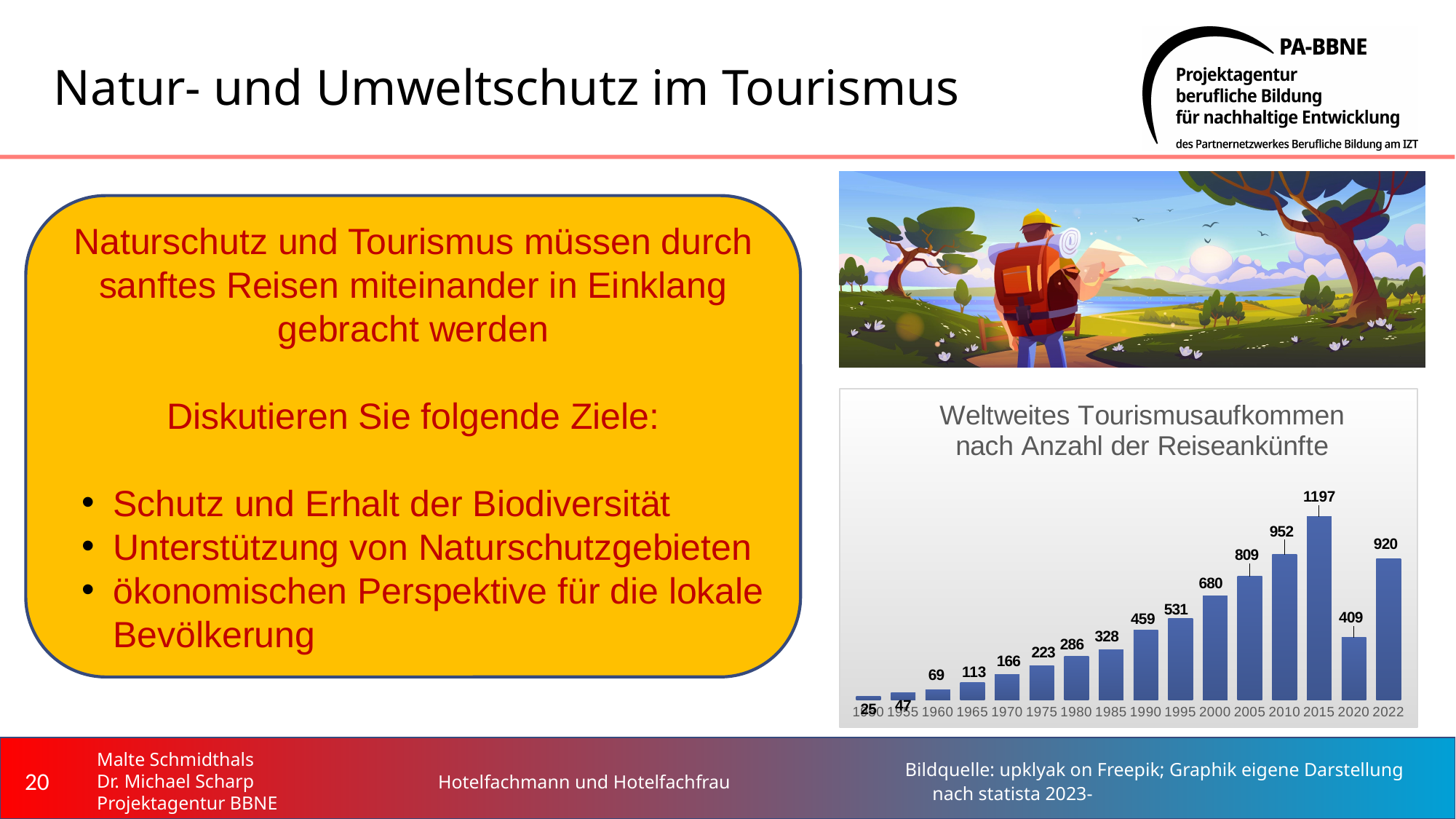
What is the value shown for 2022? 920 What is the lowest value shown in the chart? 25 What is the difference between the values for 2015 and 2020? 788 Which year has the highest value in the chart? 2015 What kind of chart is shown on the slide? bar chart What is the title of the chart on the slide? Weltweites Tourismusaufkommen nach Anzahl der Reiseankünfte What is the difference between the values for 2022 and 2010? 32 How many bars are shown in the chart? 16 What is the value shown for 1990? 459 What is the value shown for 2015? 1197 Which is larger, the value for 2005 or the value for 2022? 2022 What is the value shown for 2020? 409